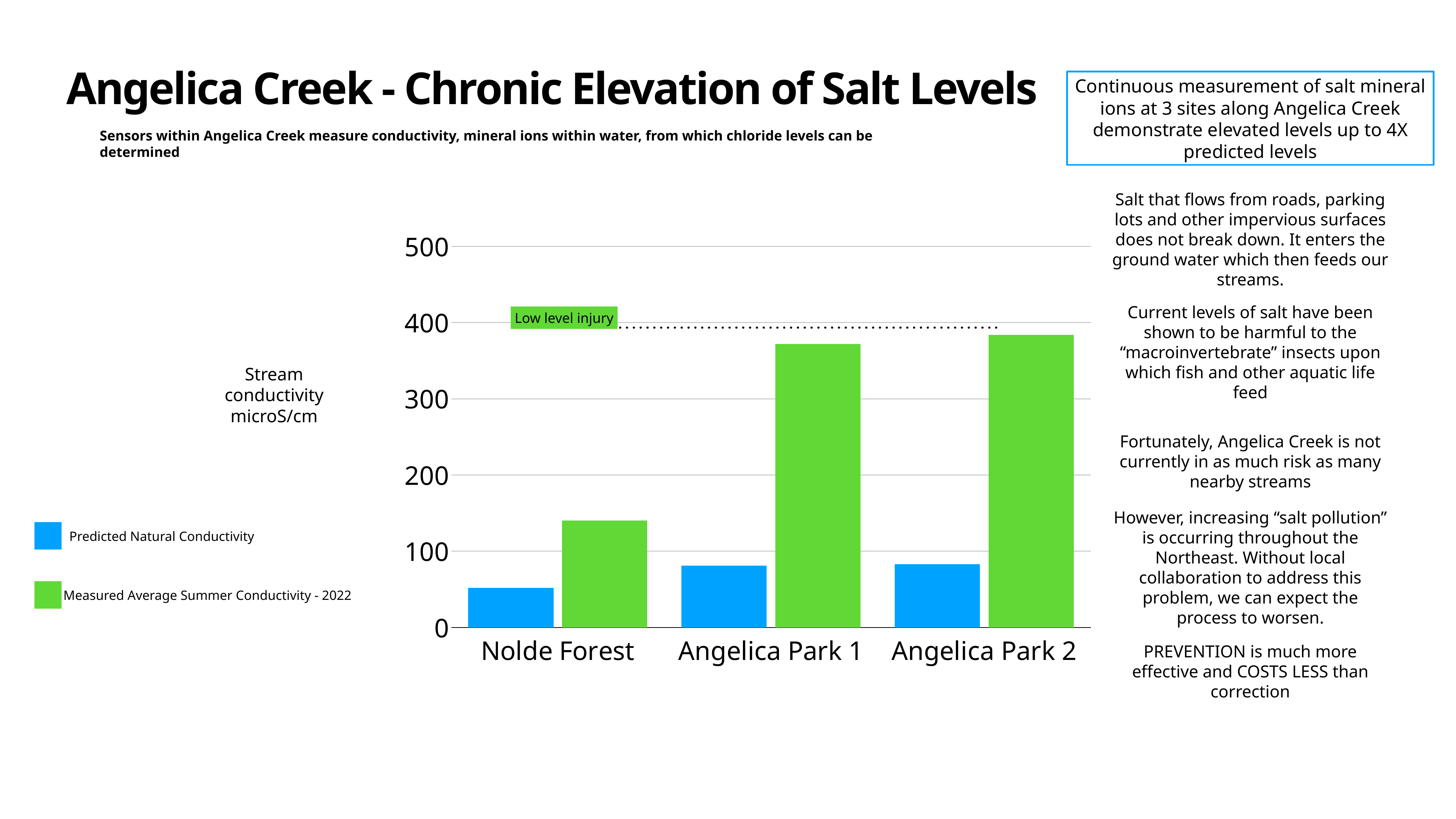
How many sites (categories) are shown on the x axis of the chart? 3 Which site has the lowest Predicted Natural Conductivity? Nolde Forest Which is larger: the Measured Average Summer Conductivity - 2022 for Nolde Forest or for Angelica Park 1? Angelica Park 1 At Nolde Forest, which is larger: the Predicted Natural Conductivity or the Measured Average Summer Conductivity - 2022? Measured Average Summer Conductivity - 2022 Is the Predicted Natural Conductivity for Nolde Forest greater or less than 100? less What label is attached to the dotted horizontal line near 400 on the chart? Low level injury What kind of chart is shown on the slide? bar chart How many series does the chart's legend list? 2 Is the Measured Average Summer Conductivity - 2022 for Angelica Park 1 greater or less than 400? less Is the Measured Average Summer Conductivity - 2022 for Nolde Forest greater or less than 100? greater Which site has the lowest Measured Average Summer Conductivity - 2022? Nolde Forest